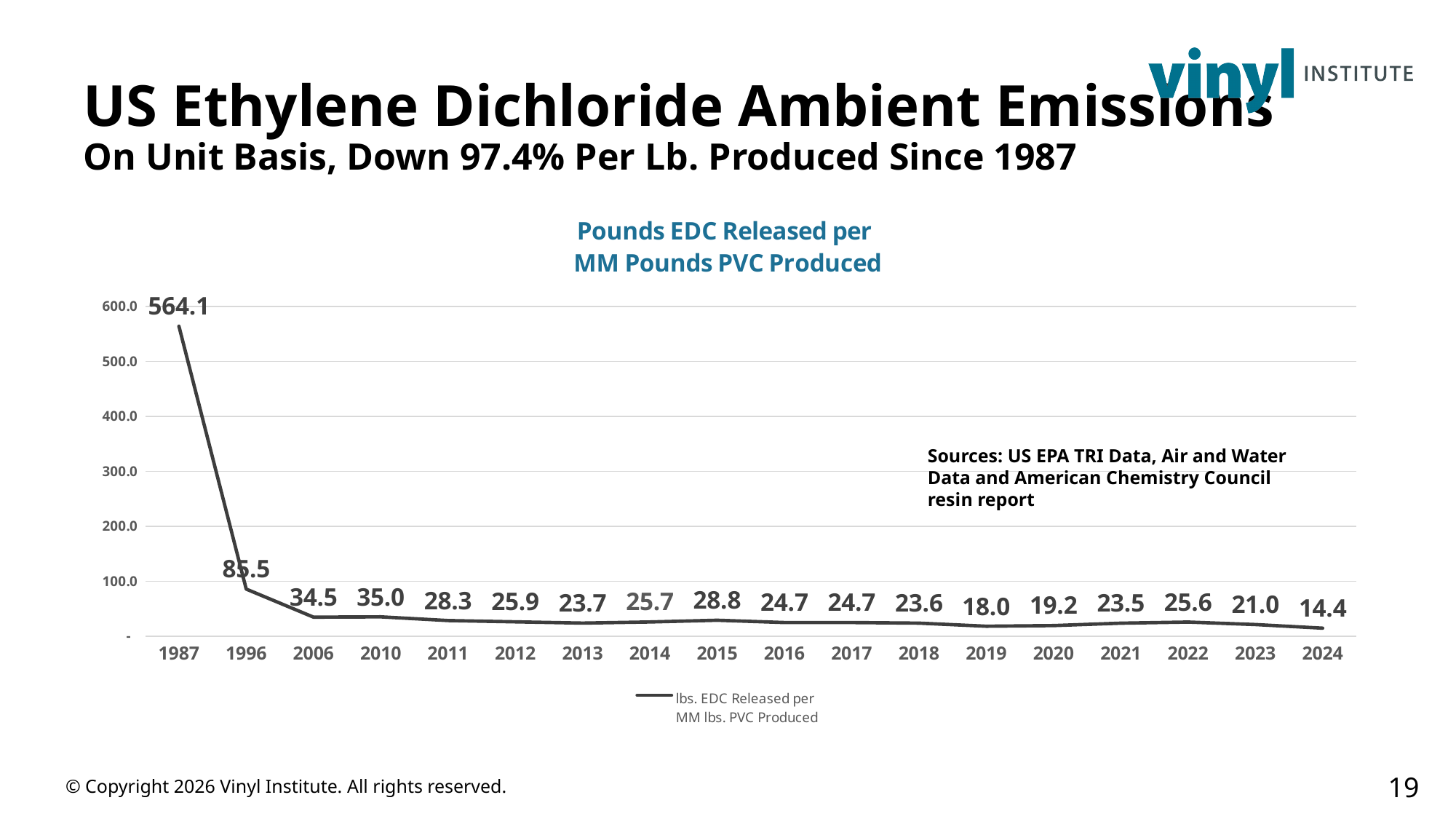
What is the value for 2015? 28.8 What is the chart's title? Pounds EDC Released per MM Pounds PVC Produced How many series does the legend list? 1 What is the value for 1987? 564.1 What is the difference between the values for 2023 and 2024? 6.6 What is the value for 2024? 14.4 Which is larger, the value for 2019 or the value for 2020? 2020 What kind of chart is shown? line chart Which year has the highest value? 1987 Which year has the lowest value? 2024 What is the difference between the values for 1996 and 2006? 51.0 How many years are plotted on the chart? 18